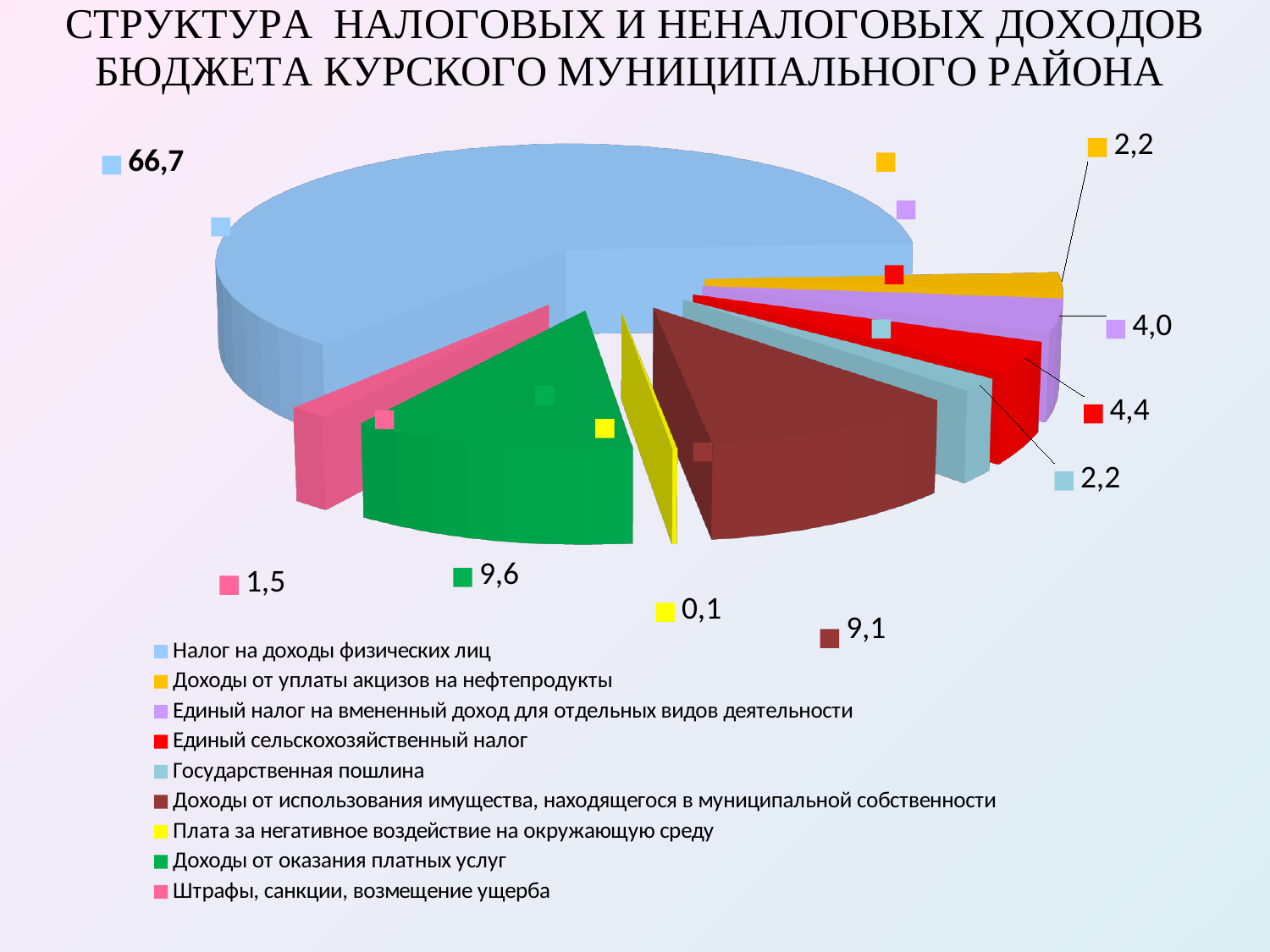
What is the value for Налог на доходы физических лиц? 66,7 Which category has the largest share of the pie? Налог на доходы физических лиц Which is larger: Единый налог на вмененный доход для отдельных видов деятельности or Единый сельскохозяйственный налог? Единый сельскохозяйственный налог What kind of chart is shown on the slide? pie chart How many categories does the pie chart have? 9 What colour is the slice for Государственная пошлина? light blue (teal) What is the value for Единый сельскохозяйственный налог? 4,4 What is the value for Доходы от оказания платных услуг? 9,6 What is the value for Плата за негативное воздействие на окружающую среду? 0,1 What is the difference between the values for Доходы от оказания платных услуг and Доходы от использования имущества, находящегося в муниципальной собственности? 0,5 What is the value for Штрафы, санкции, возмещение ущерба? 1,5 Which category has the smallest share of the pie? Плата за негативное воздействие на окружающую среду